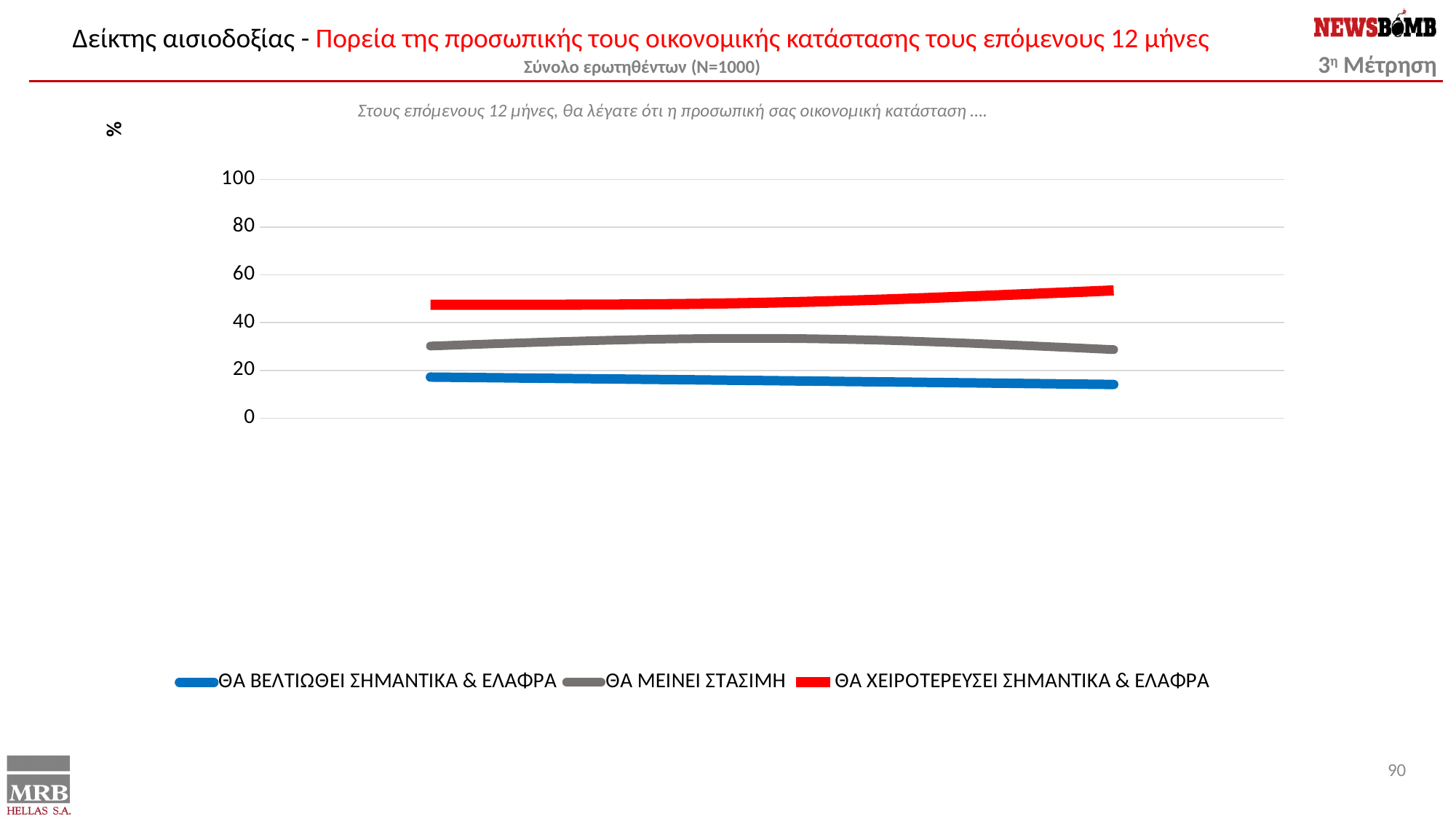
Which series has the highest values across the chart? ΘΑ ΧΕΙΡΟΤΕΡΕΥΣΕΙ ΣΗΜΑΝΤΙΚΑ & ΕΛΑΦΡΑ Is the value for ΘΑ ΧΕΙΡΟΤΕΡΕΥΣΕΙ ΣΗΜΑΝΤΙΚΑ & ΕΛΑΦΡΑ at the right end of the line greater or less than 40? greater Which series has the lowest values across the chart? ΘΑ ΒΕΛΤΙΩΘΕΙ ΣΗΜΑΝΤΙΚΑ & ΕΛΑΦΡΑ At the right end of the chart, which is larger: the value for ΘΑ ΜΕΙΝΕΙ ΣΤΑΣΙΜΗ or the value for ΘΑ ΒΕΛΤΙΩΘΕΙ ΣΗΜΑΝΤΙΚΑ & ΕΛΑΦΡΑ? ΘΑ ΜΕΙΝΕΙ ΣΤΑΣΙΜΗ Which series is plotted with the blue line? ΘΑ ΒΕΛΤΙΩΘΕΙ ΣΗΜΑΝΤΙΚΑ & ΕΛΑΦΡΑ Does the line for ΘΑ ΒΕΛΤΙΩΘΕΙ ΣΗΜΑΝΤΙΚΑ & ΕΛΑΦΡΑ rise or fall from left to right? fall Which series is plotted with the red line? ΘΑ ΧΕΙΡΟΤΕΡΕΥΣΕΙ ΣΗΜΑΝΤΙΚΑ & ΕΛΑΦΡΑ How many series does the legend list? 3 Is the value for ΘΑ ΜΕΙΝΕΙ ΣΤΑΣΙΜΗ at the left end of the line greater or less than 40? less Does the line for ΘΑ ΧΕΙΡΟΤΕΡΕΥΣΕΙ ΣΗΜΑΝΤΙΚΑ & ΕΛΑΦΡΑ rise or fall from left to right? rise Is the value for ΘΑ ΒΕΛΤΙΩΘΕΙ ΣΗΜΑΝΤΙΚΑ & ΕΛΑΦΡΑ at the right end of the line greater or less than 20? less What kind of chart is shown on the slide? line chart